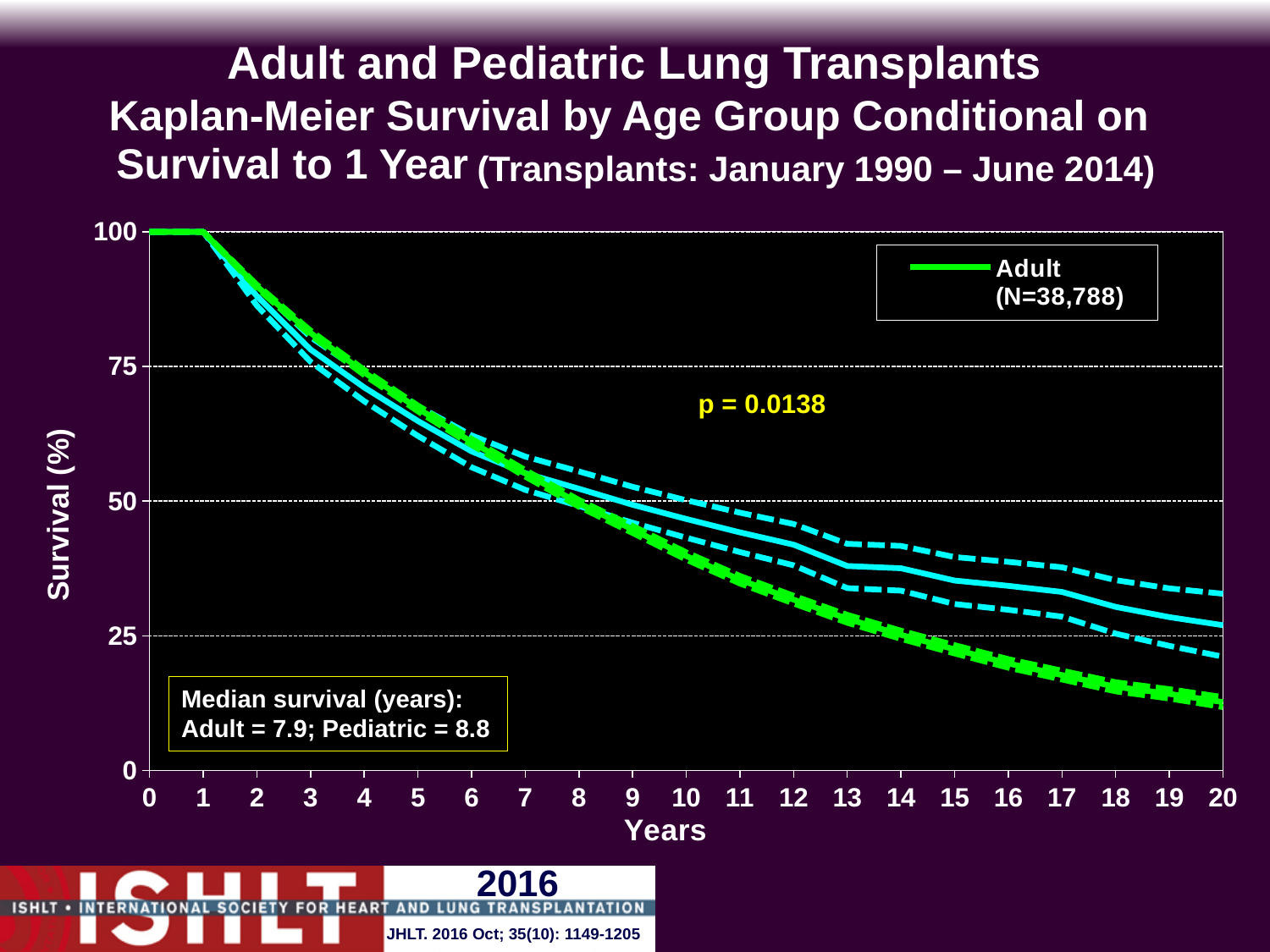
What kind of chart is shown on the slide? Line chart Is the Adult survival curve at year 20 greater or less than 25%? less Is the Adult survival curve at year 10 greater or less than 50%? less Do the survival curves rise or fall as years increase along the x axis? fall What is the median survival in years for the Pediatric group? 8.8 Is the Adult survival curve at year 5 greater or less than 50%? greater What p-value is shown on the chart? p = 0.0138 What is the median survival in years for the Adult group? 7.9 Which group has the longer median survival, Adult or Pediatric? Pediatric What is the difference in median survival (years) between the Pediatric and Adult groups? 0.9 What is the label of the y axis? Survival (%) What is the N for the Adult group shown in the legend? N=38,788